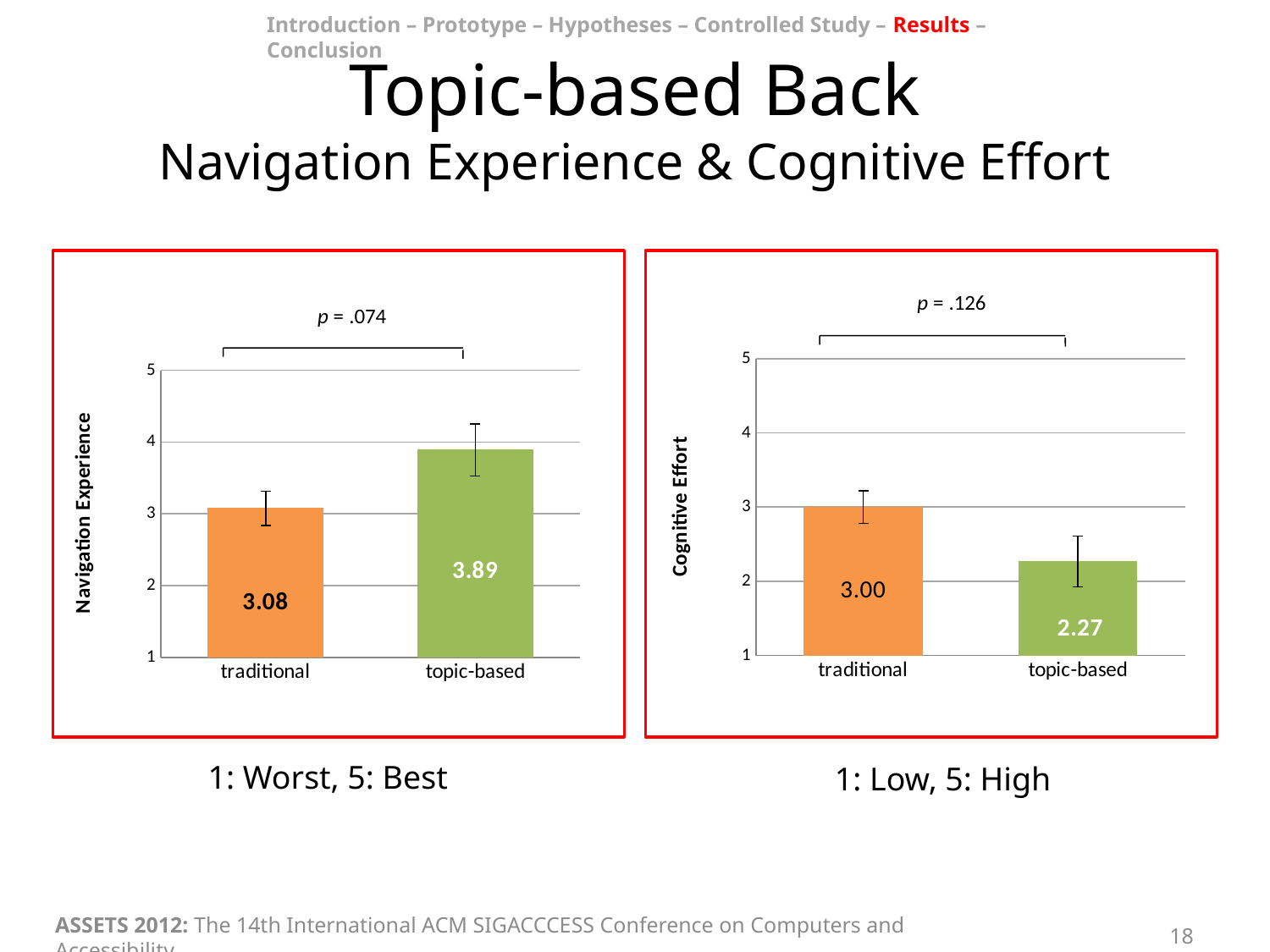
In the Cognitive Effort chart (right), what is the difference between the traditional and topic-based values? 0.73 In the Cognitive Effort chart (right), what is the value for traditional? 3.00 How many categories are shown in the Navigation Experience chart (left)? 2 In the Navigation Experience chart (left), what is the value for traditional? 3.08 In the Navigation Experience chart (left), what is the difference between the topic-based and traditional values? 0.81 In the Cognitive Effort chart (right), what is the value for topic-based? 2.27 In the Cognitive Effort chart (right), is the value for traditional larger or smaller than the value for topic-based? larger What p-value is shown above the bars in the Navigation Experience chart (left)? p = .074 In the Cognitive Effort chart (right), which category has the lower value? topic-based What kind of chart is the Cognitive Effort chart (right)? bar chart In the Navigation Experience chart (left), which category has the higher value? topic-based In the Navigation Experience chart (left), what is the value for topic-based? 3.89